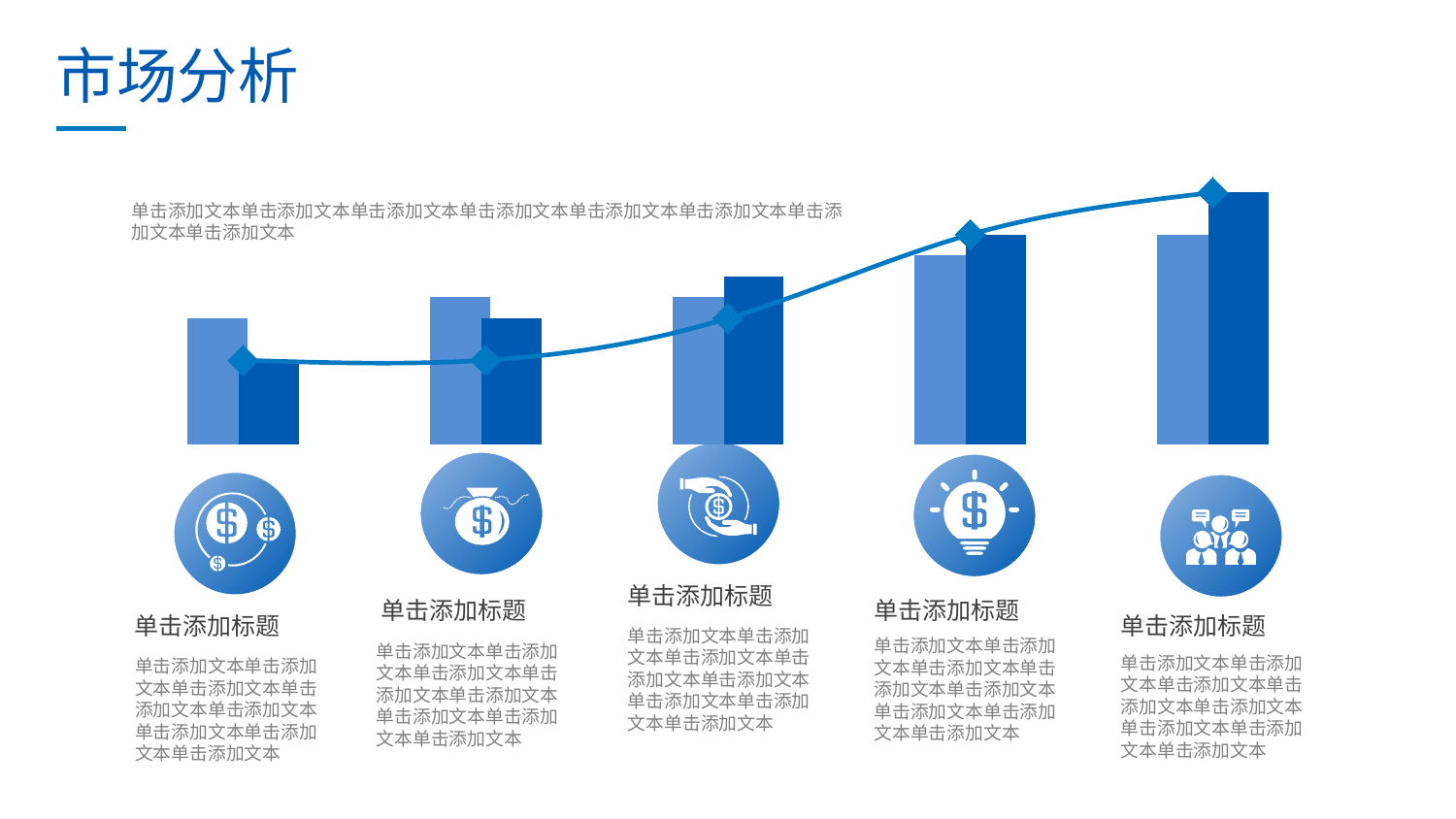
Is the line point in the fourth group higher or lower than the line point in the second group? Higher Which group of bars is the tallest: the leftmost or the rightmost? The rightmost How many bars are in each group of the chart? 2 Is the dark blue bar in the rightmost group taller or shorter than the dark blue bar in the leftmost group? Taller How many points are plotted on the line in the chart? 5 How many groups of bars does the chart have? 5 What kind of chart is shown on the slide? A bar chart with a line overlaid Do the dark blue bars generally rise or fall from left to right? Rise What is the title of the slide containing the chart? 市场分析 Do the values of the line rise or fall from left to right across the chart? Rise Which group of bars is the shortest in the chart? The leftmost group